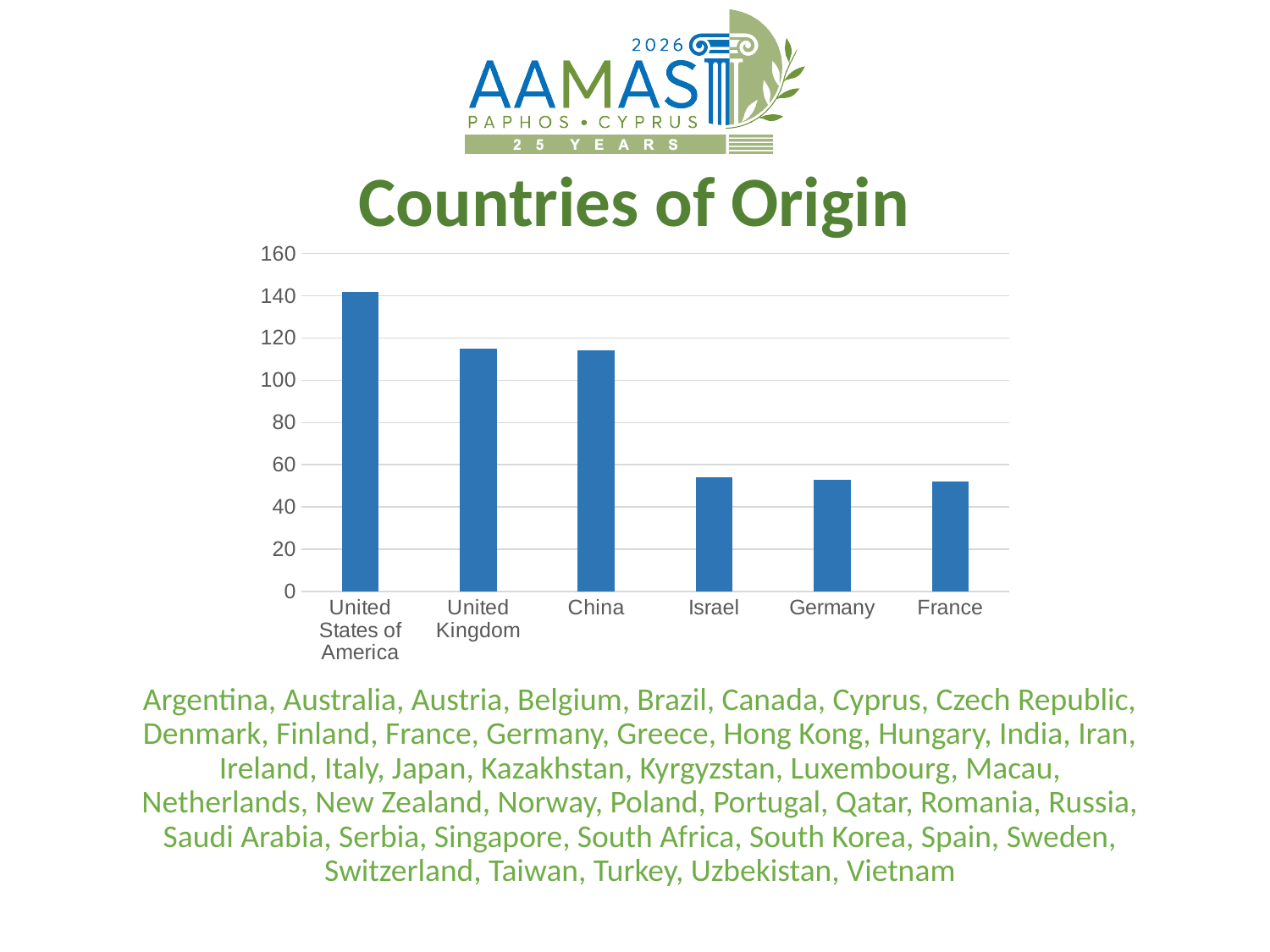
What is the title of the chart? Countries of Origin Is the value for Israel greater or less than 60? less Do the bar values generally rise or fall from left to right across the chart? fall Which country has the highest bar in the chart? United States of America Is the value for Germany greater or less than 40? greater Is the value for France greater or less than 60? less How many countries are shown as bars in the chart? 6 Which has a larger value, United States of America or Israel? United States of America What type of chart is shown on the slide? bar chart